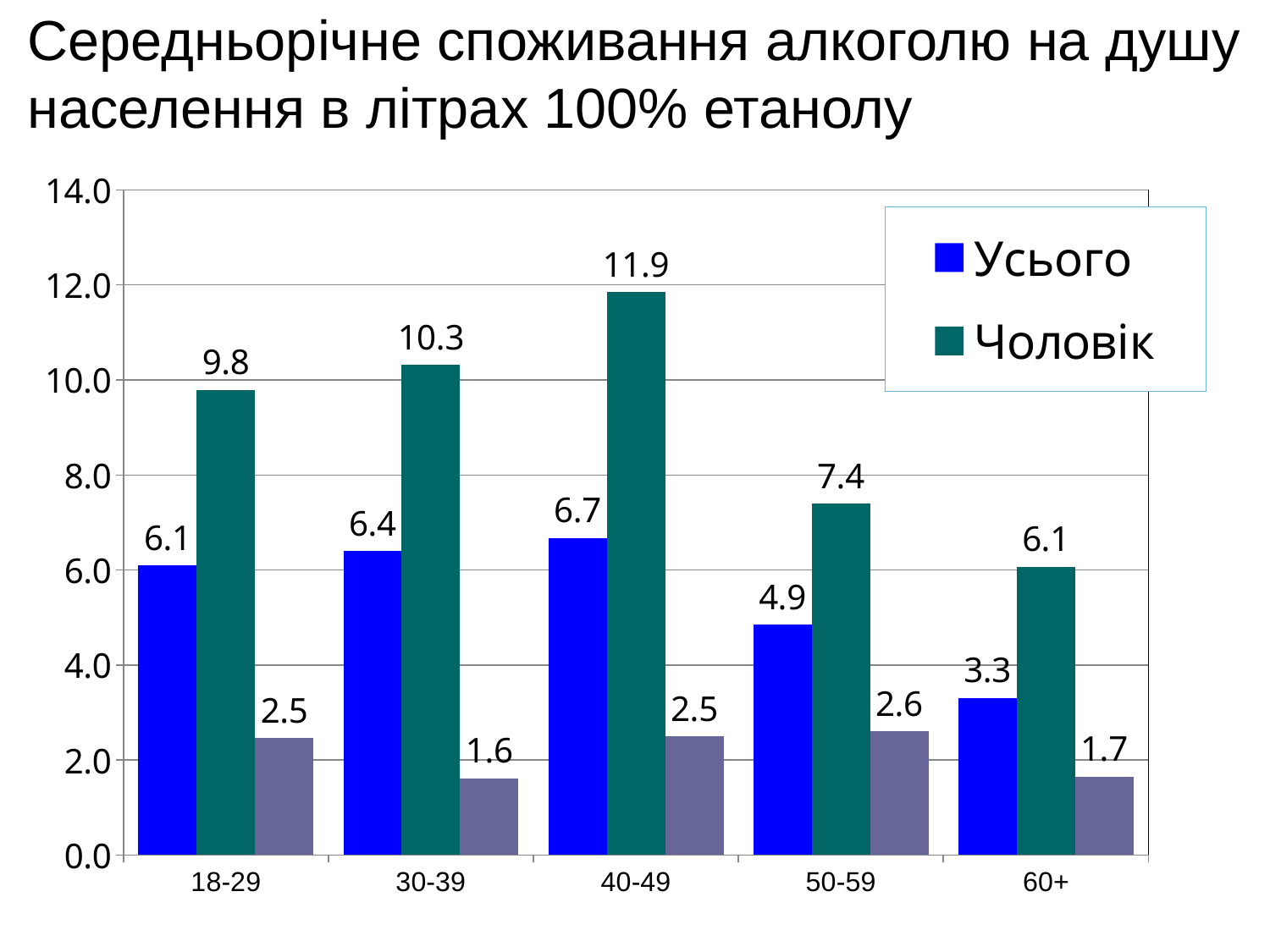
What is the difference between the Чоловік values for 40-49 and 50-59? 4.5 How many age groups are shown on the x axis? 5 What is the difference between the Чоловік and Усього values in the 18-29 age group? 3.7 What is the value for Усього in the 18-29 age group? 6.1 What is the value for Усього in the 50-59 age group? 4.9 Do the Чоловік values rise or fall from the 40-49 group to the 60+ group? fall Which age group has the lowest value for Усього? 60+ What kind of chart is shown on the slide? bar chart Is the value for Чоловік in the 30-39 age group greater or less than 10.0? greater Which age group has the highest value for Чоловік? 40-49 What is the value for Чоловік in the 40-49 age group? 11.9 Which is larger, the Усього value for 30-39 or for 60+? 30-39